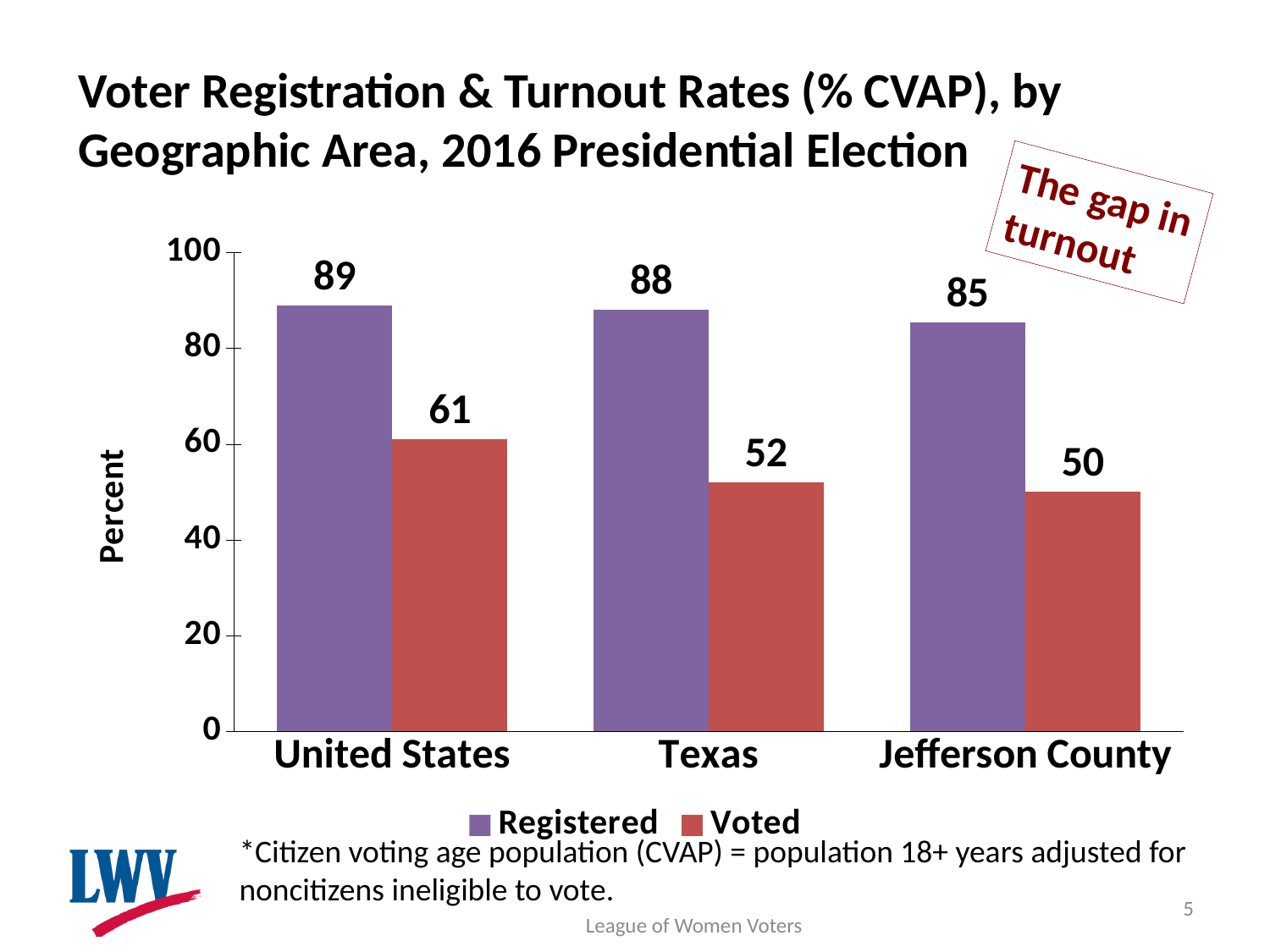
How many geographic areas are shown on the x axis? 3 What is the difference between the Voted values for the United States and Jefferson County? 11 What is the Voted value for the United States? 61 What is the difference between the Registered and Voted values for Texas? 36 Which geographic area has the lowest Registered value? Jefferson County Which is larger, the Registered value for the United States or the Registered value for Jefferson County? United States Which geographic area has the highest Voted value? United States How many series does the legend list? 2 What is the Voted value for Jefferson County? 50 What is the label on the vertical axis? Percent What is the Registered value for Texas? 88 What kind of chart is shown on the slide? Bar chart